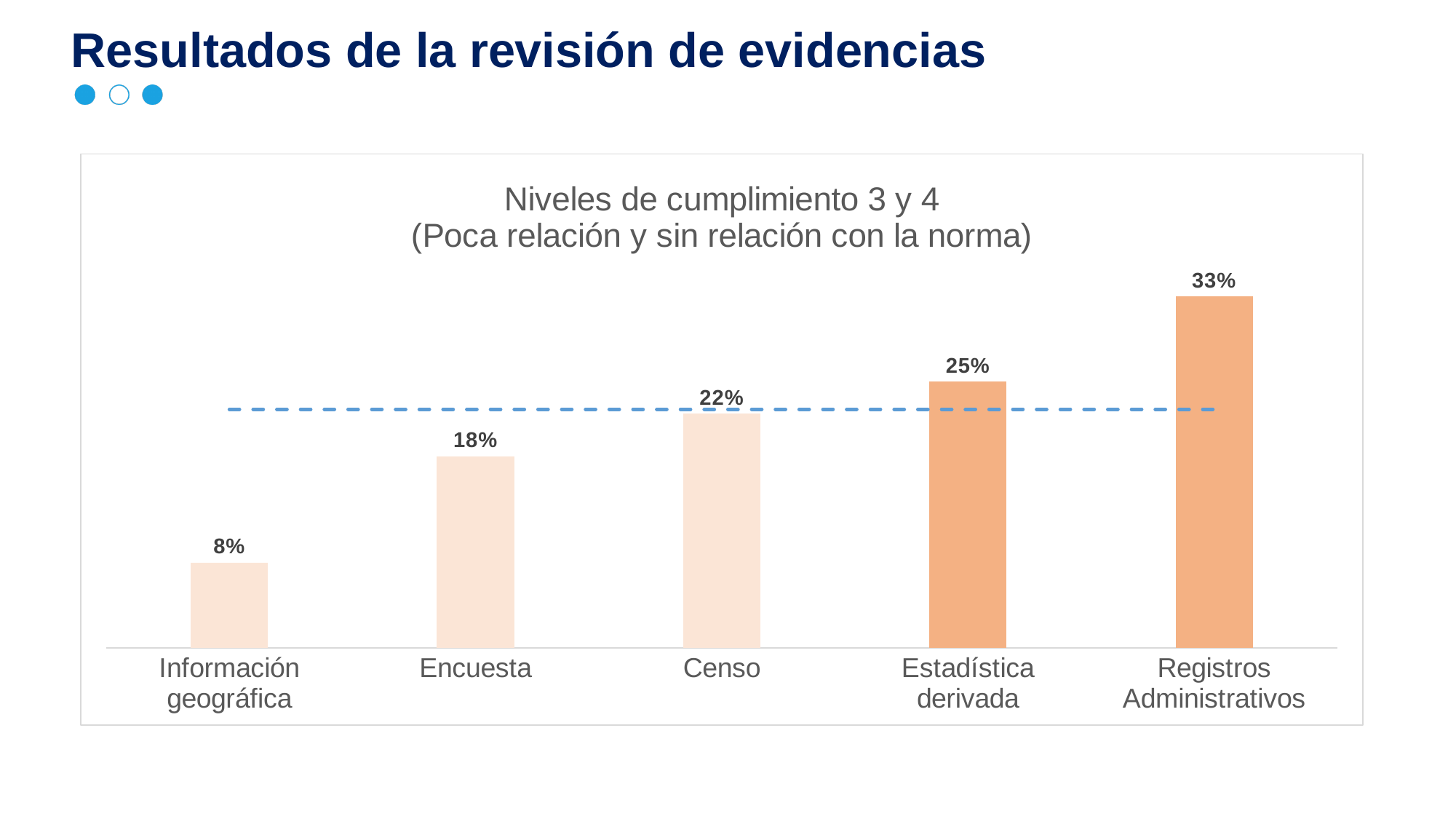
What is the title of the chart? Niveles de cumplimiento 3 y 4 (Poca relación y sin relación con la norma) Which category has the lowest value? Información geográfica What is the value for Censo? 22% What is the difference between the values for Registros Administrativos and Estadística derivada? 8% How many categories are shown on the x axis? 5 What kind of chart is shown on the slide? Bar chart What is the difference between the values for Encuesta and Información geográfica? 10% What is the value for Registros Administrativos? 33% Which category has the highest value? Registros Administrativos What is the value for Información geográfica? 8% Do the values rise or fall from left to right along the x axis? Rise Which is larger, the value for Encuesta or the value for Censo? Censo